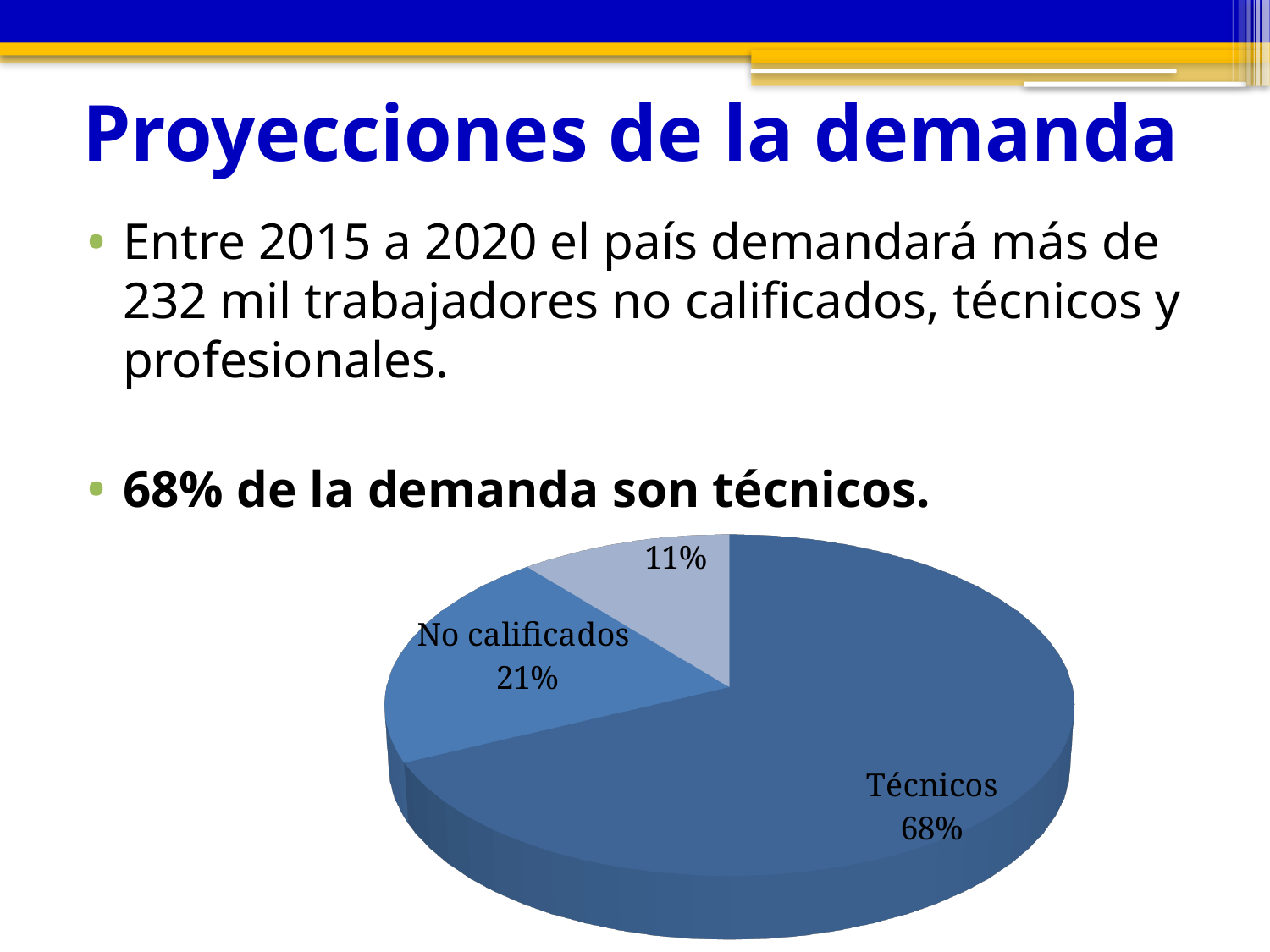
What percentage is shown for No calificados? 21% What share of the pie does the Técnicos slice represent? 68% Which category has the largest slice of the pie? Técnicos Is the share for No calificados greater or less than 50%? less Which is larger, the Técnicos slice or the No calificados slice? Técnicos Does the pie chart include a legend? No What is the difference in percentage points between Técnicos and No calificados? 47 What kind of chart is shown on the slide? Pie chart Which slice of the pie is the darkest blue? Técnicos What percentage is shown on the smallest slice of the pie? 11% How many slices does the pie chart have? 3 What is the sum of the three percentages shown on the pie chart? 100%